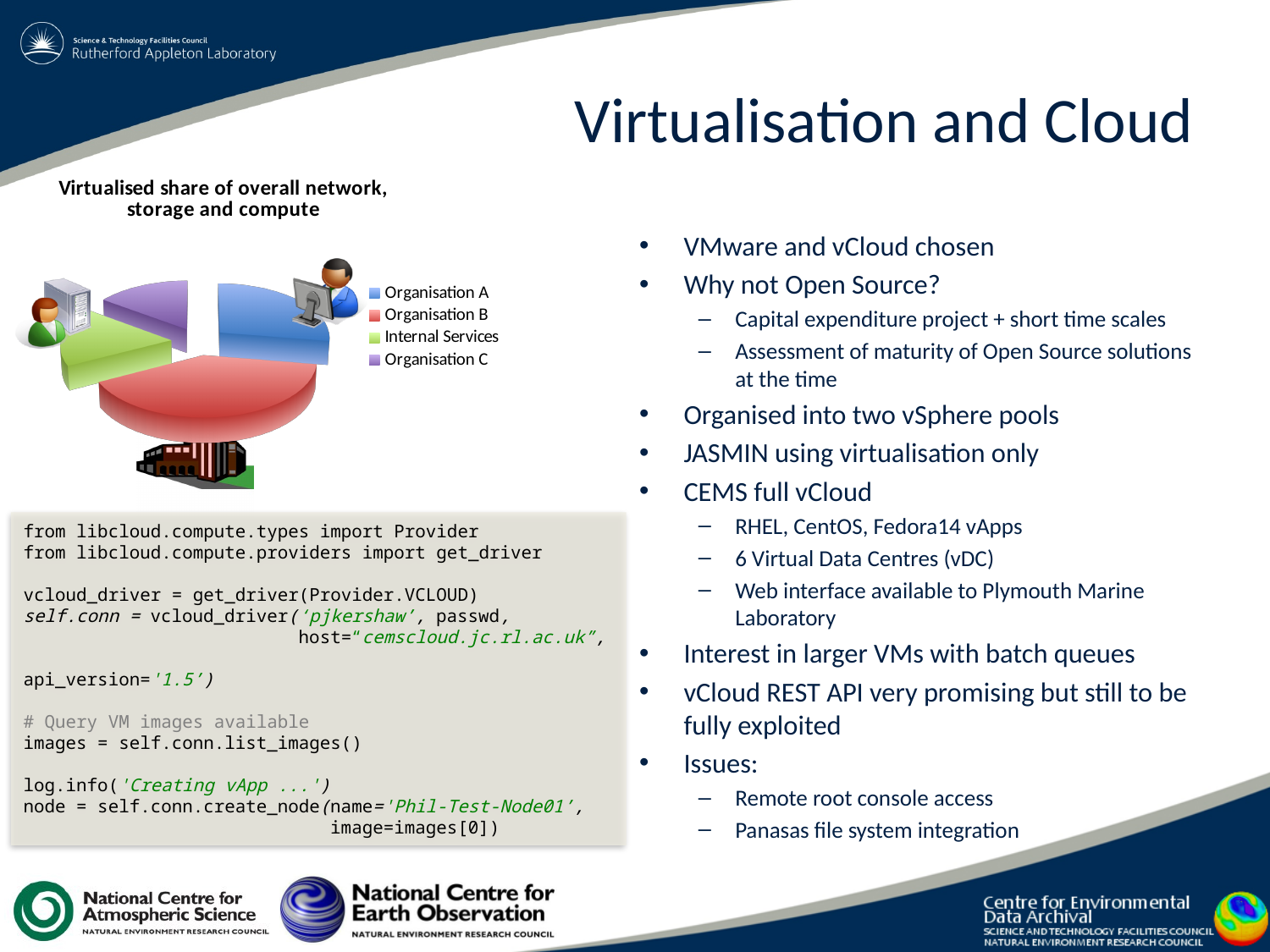
What kind of chart is shown under the title "Virtualised share of overall network, storage and compute"? pie chart In the pie chart, which slice is larger: Organisation B or Internal Services? Organisation B Which category has the largest slice in the pie chart? Organisation B How many entries does the legend of the pie chart list? 4 Which colour represents Internal Services in the pie chart? green What is the title of the pie chart? Virtualised share of overall network, storage and compute In the pie chart, which slice is larger: Organisation B or Organisation C? Organisation B How many slices does the pie chart have? 4